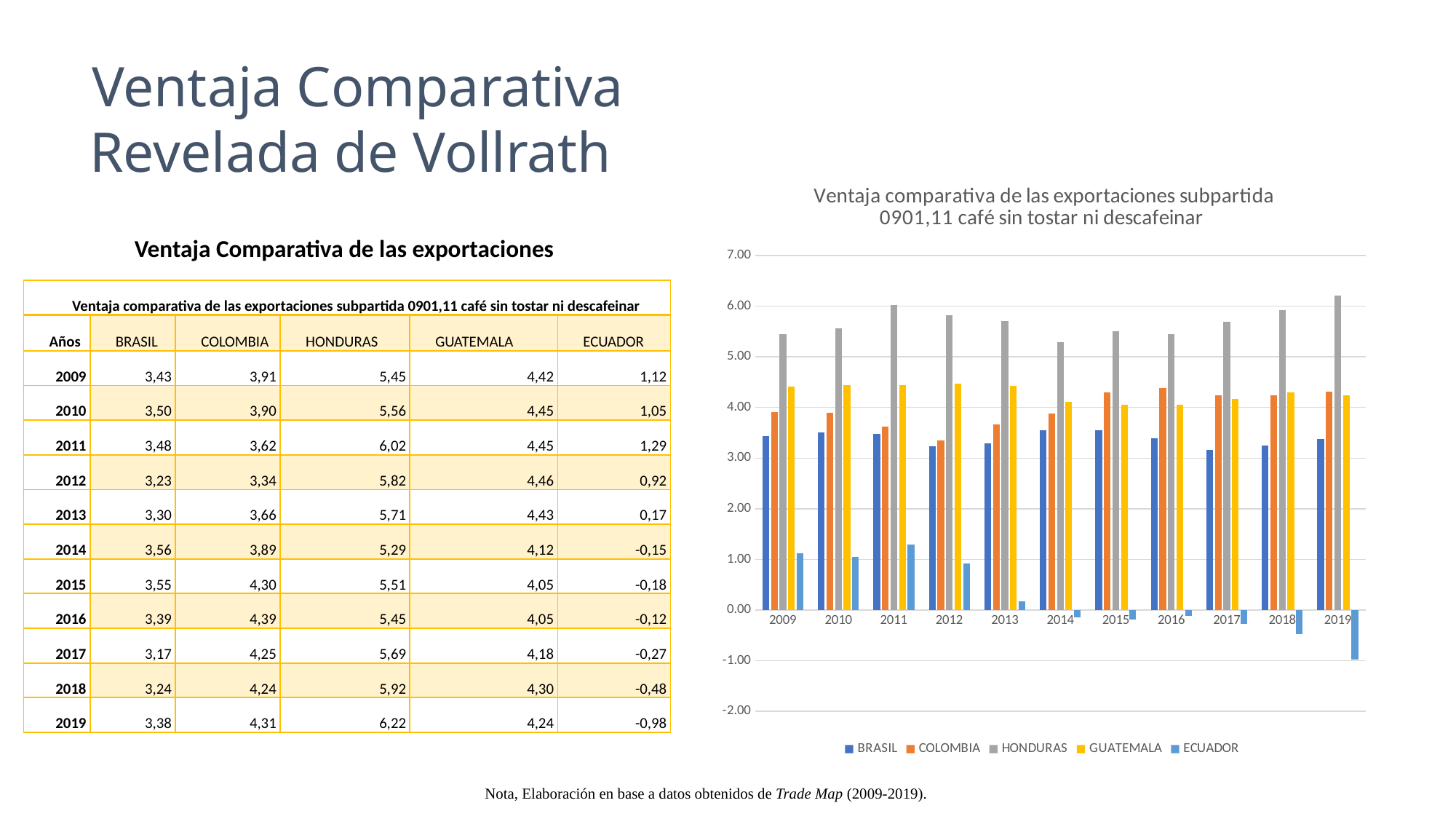
What is the value for HONDURAS in 2019, as printed in the table? 6,22 Is the value for BRASIL in 2017 greater or less than 4.00? less Is the value for ECUADOR in 2014 greater or less than 0.00? less How many years are shown along the x axis of the chart? 11 Which country has the lowest value in 2019? ECUADOR How many series does the chart legend list? 5 Do the values for ECUADOR rise or fall from 2009 to 2019? fall Which country has the highest bar in every year of the chart? HONDURAS Is the value for HONDURAS in 2019 greater or less than 6.00? greater In 2009, which is larger: the value for COLOMBIA or the value for BRASIL? COLOMBIA What is the title of the chart? Ventaja comparativa de las exportaciones subpartida 0901,11 café sin tostar ni descafeinar What kind of chart is shown on the slide? bar chart